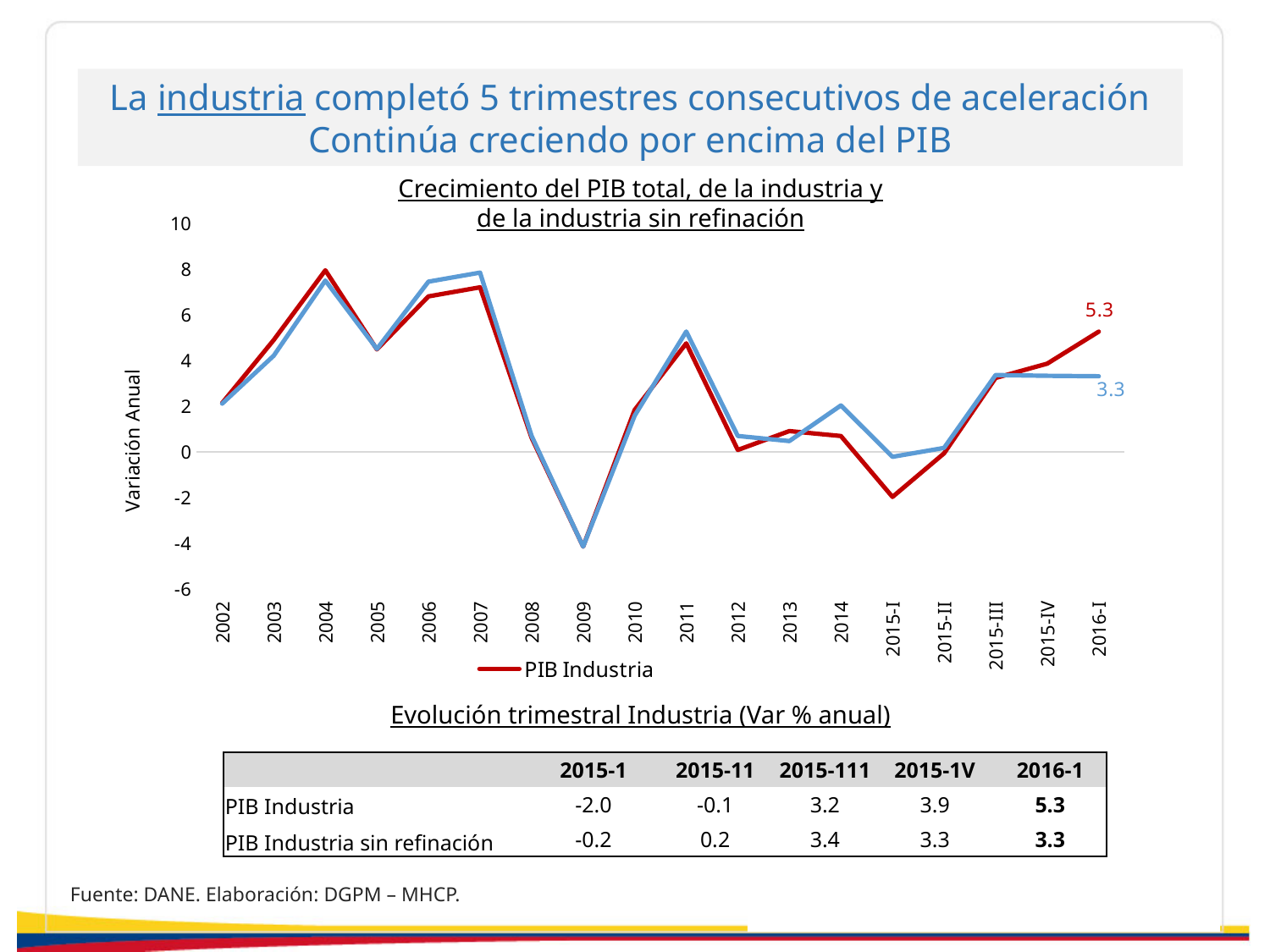
What is the value of the PIB Industria line at 2016-I? 5.3 In which year does the PIB Industria line reach its lowest point? 2009 What kind of chart is shown on the slide? line chart What is the value of the blue line (PIB Industria sin refinación) at 2016-I? 3.3 Is the PIB Industria value for 2006 greater or less than 6? greater Does the PIB Industria line rise or fall from 2015-I to 2016-I? rise How many categories are shown on the x axis of the chart? 18 What is the difference between the red and blue line values at 2016-I? 2.0 Is the PIB Industria value for 2009 greater or less than -2? less What is the label on the vertical axis of the chart? Variación Anual At 2016-I, which line is higher: the red PIB Industria line or the blue line? PIB Industria In which year does the PIB Industria line reach its highest point? 2004